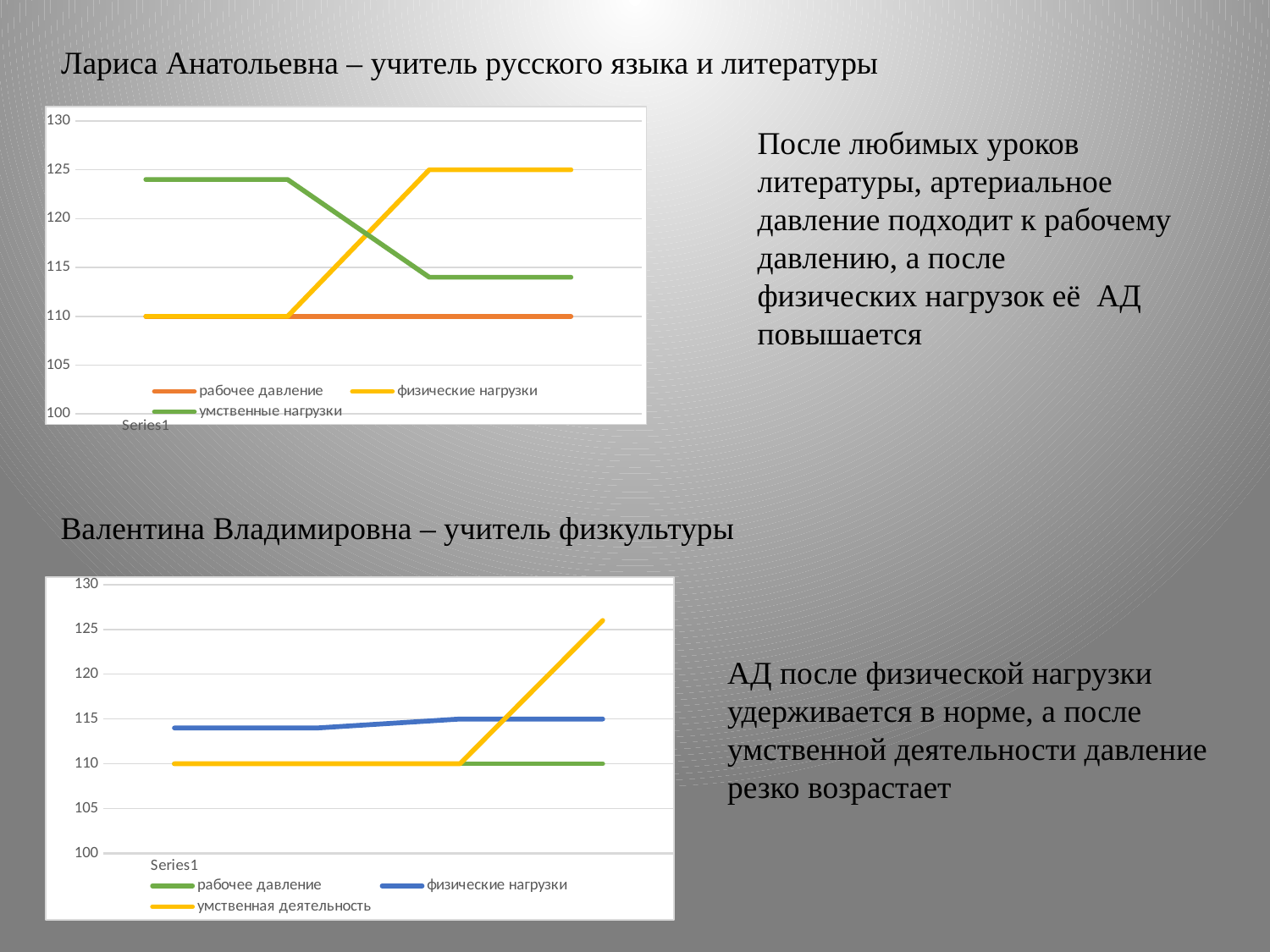
How many series does the legend of the top chart list? 3 What kind of chart is the top chart (Лариса Анатольевна)? line chart In the top chart, does the line for умственные нагрузки rise or fall along the x axis? fall In the bottom chart, which series is shown in blue? физические нагрузки In the top chart, does the line for физические нагрузки rise or fall along the x axis? rise How many series does the legend of the bottom chart list? 3 In the bottom chart, does the line for умственная деятельность rise or fall along the x axis? rise In the top chart, which series is shown in orange? рабочее давление What kind of chart is the bottom chart (Валентина Владимировна)? line chart In the bottom chart, at the end of the lines, which is higher: физические нагрузки or рабочее давление? физические нагрузки In the top chart, is the value for умственные нагрузки at the start of the line greater or less than 120? greater